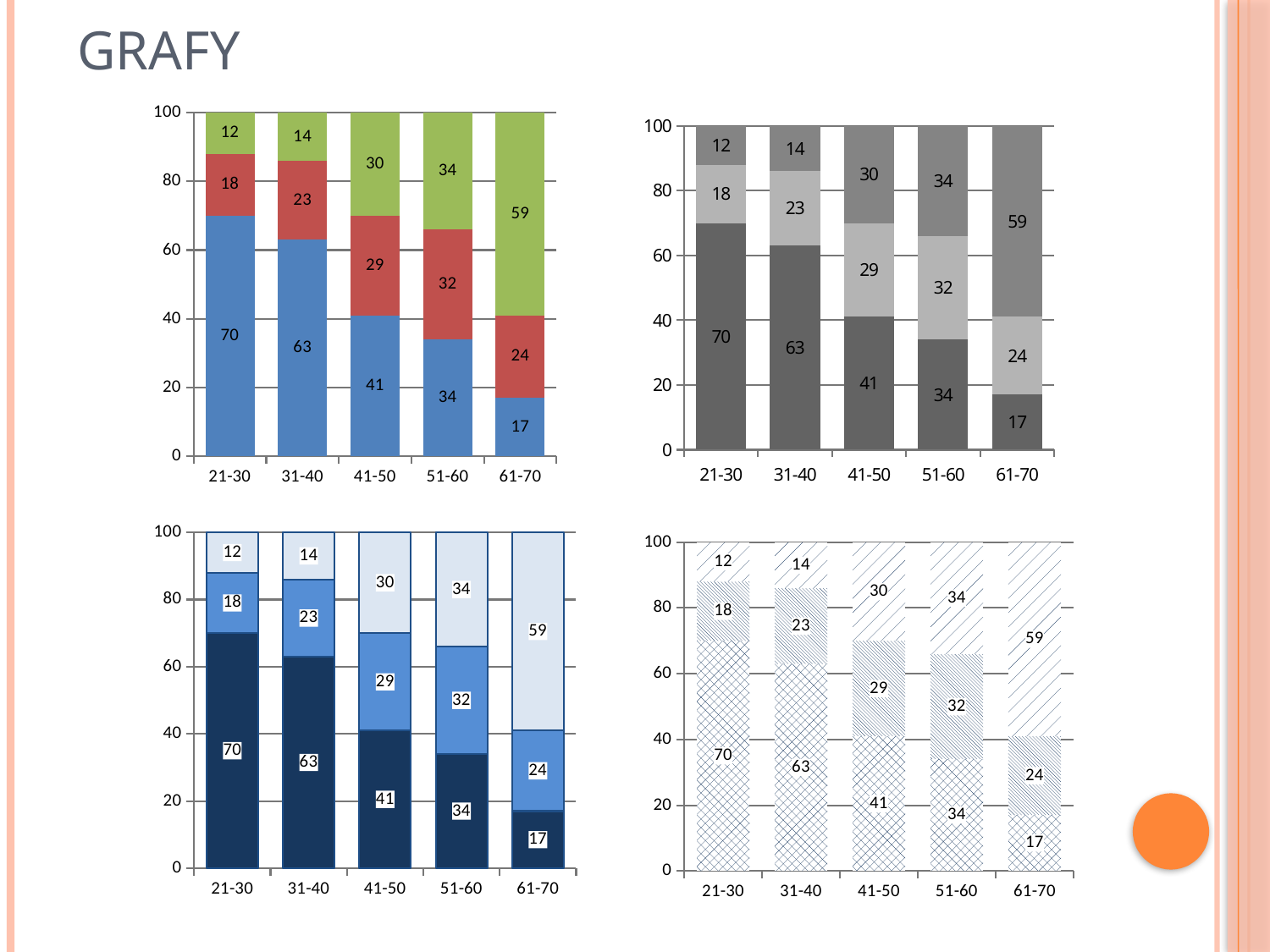
In the top-right chart, what is the value of the middle (light grey) segment for the 51-60 category? 32 In the top-left chart, do the bottom (blue) segment values rise or fall from 21-30 to 61-70? Fall In the top-right chart, which is larger: the top segment for 41-50 or the top segment for 31-40? 41-50 In the bottom-right chart, which category has the smallest bottom segment? 61-70 How many charts are shown on the slide? 4 In the top-left chart, what is the value of the top (green) segment for the 61-70 category? 59 How many categories are shown on the x axis of the bottom-right chart? 5 In the bottom-left chart, what is the total of the stacked bar for the 41-50 category? 100 What type of chart is the top-left chart? Stacked bar chart In the bottom-left chart, which category has the largest bottom (dark blue) segment? 21-30 In the top-left chart, what is the difference between the bottom segment values for 21-30 and 61-70? 53 In the top-left chart, what is the value of the bottom (blue) segment for the 21-30 category? 70